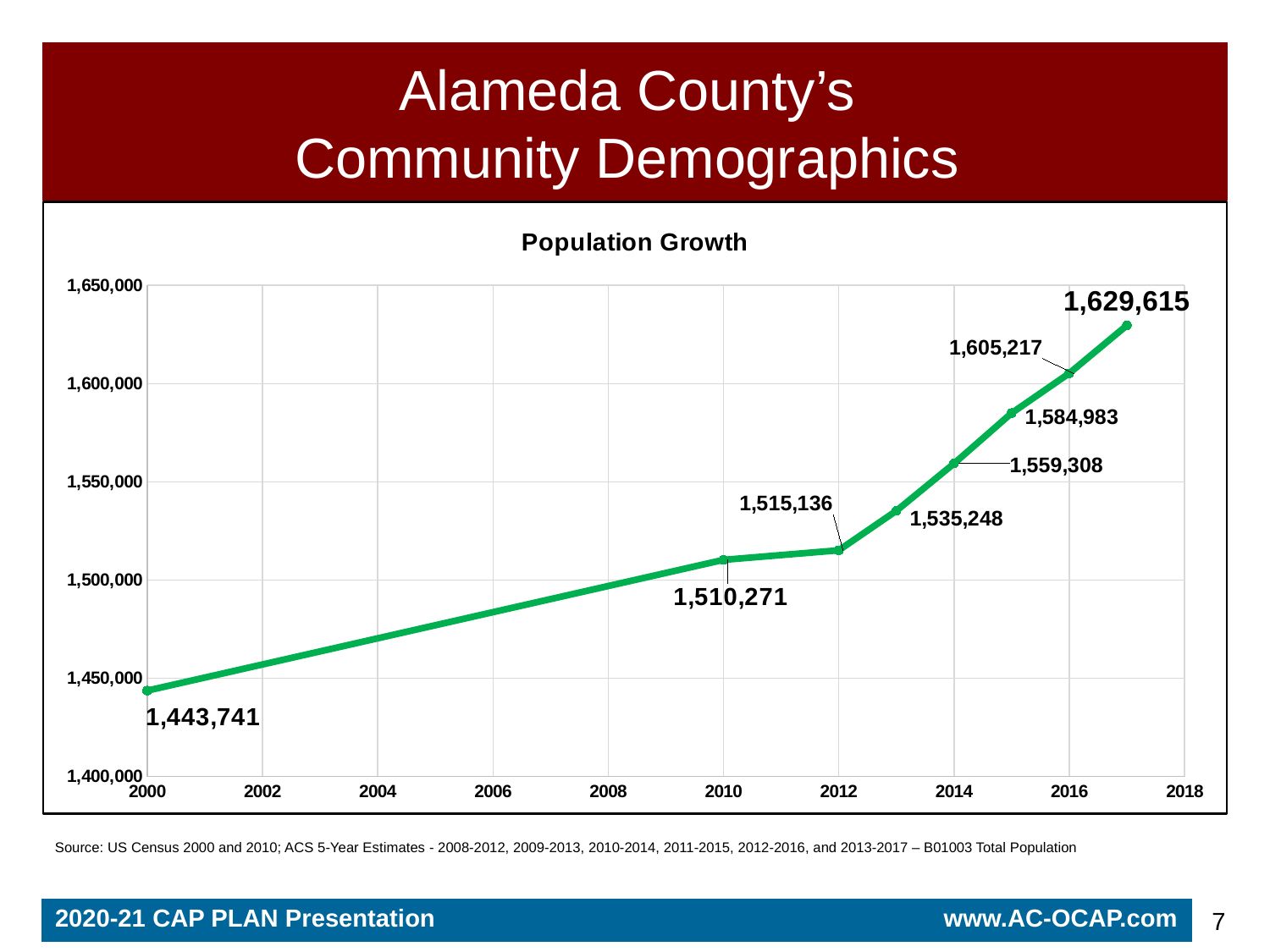
How many data points are plotted on the line? 8 What is the population value shown for 2010? 1,510,271 What kind of chart is shown on the slide? Line chart Does the population rise or fall from 2000 to 2017? Rise What is the difference between the population in 2016 and the population in 2015? 20,234 What is the difference between the population in 2017 and the population in 2000? 185,874 Which is larger, the population value for 2012 or for 2013? 2013 What is the population value shown for 2017? 1,629,615 What is the population value shown for 2014? 1,559,308 Which year has the lowest population value on the chart? 2000 What is the population value shown for 2000? 1,443,741 Which year has the highest population value on the chart? 2017